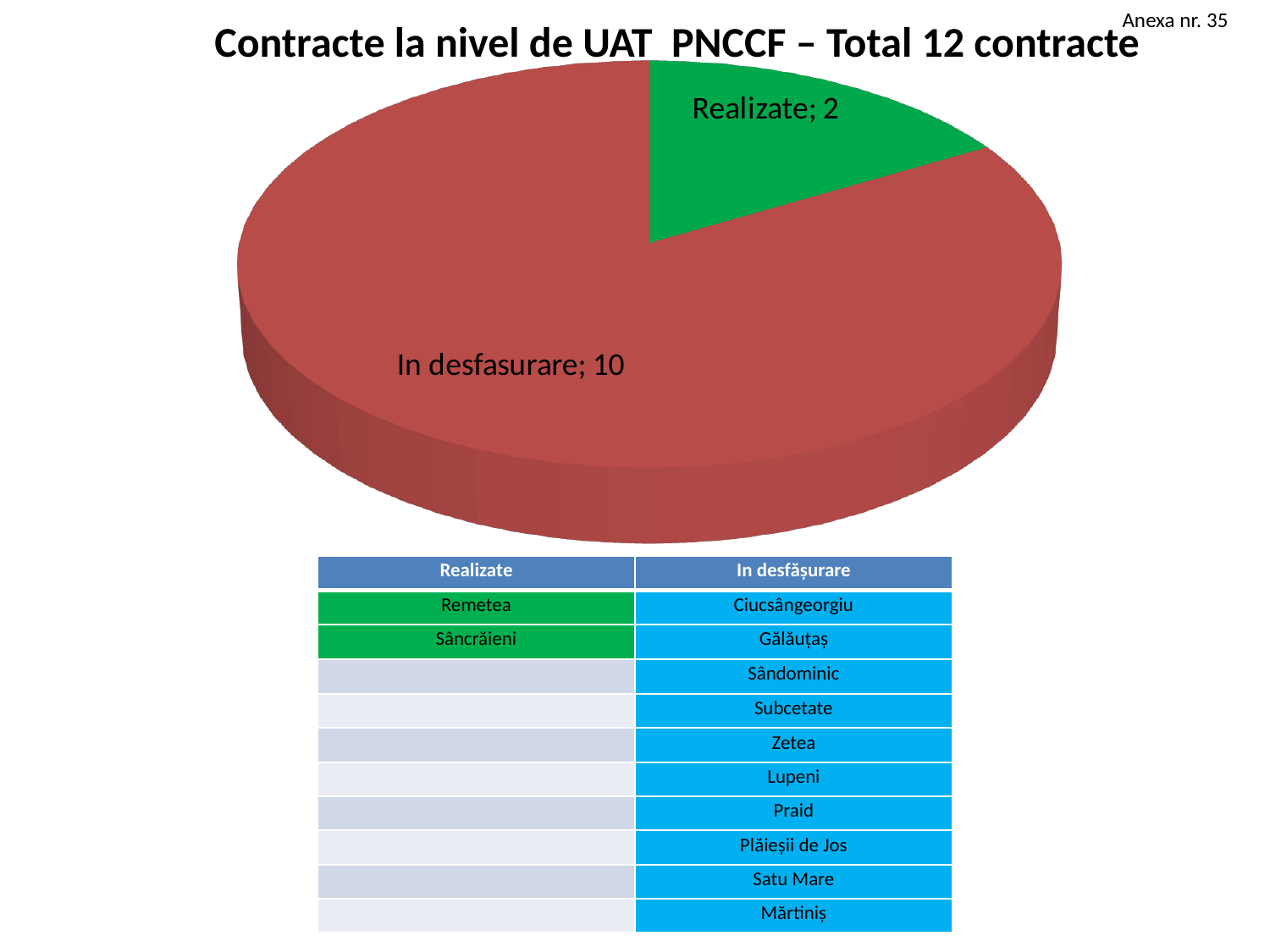
What is the value for the 'In desfasurare' slice? 10 What share of the pie does the 'Realizate' slice represent? 1/6 What is the total of the two slices in the pie chart? 12 What is the title of the chart? Contracte la nivel de UAT PNCCF – Total 12 contracte What is the value for the 'Realizate' slice? 2 Which slice is the smallest? Realizate What type of chart is shown on the slide? pie chart What colour is the 'Realizate' slice? green Which is larger, 'Realizate' or 'In desfasurare'? In desfasurare How many slices does the pie chart have? 2 What is the difference between the 'In desfasurare' and 'Realizate' values? 8 Which slice is the largest? In desfasurare